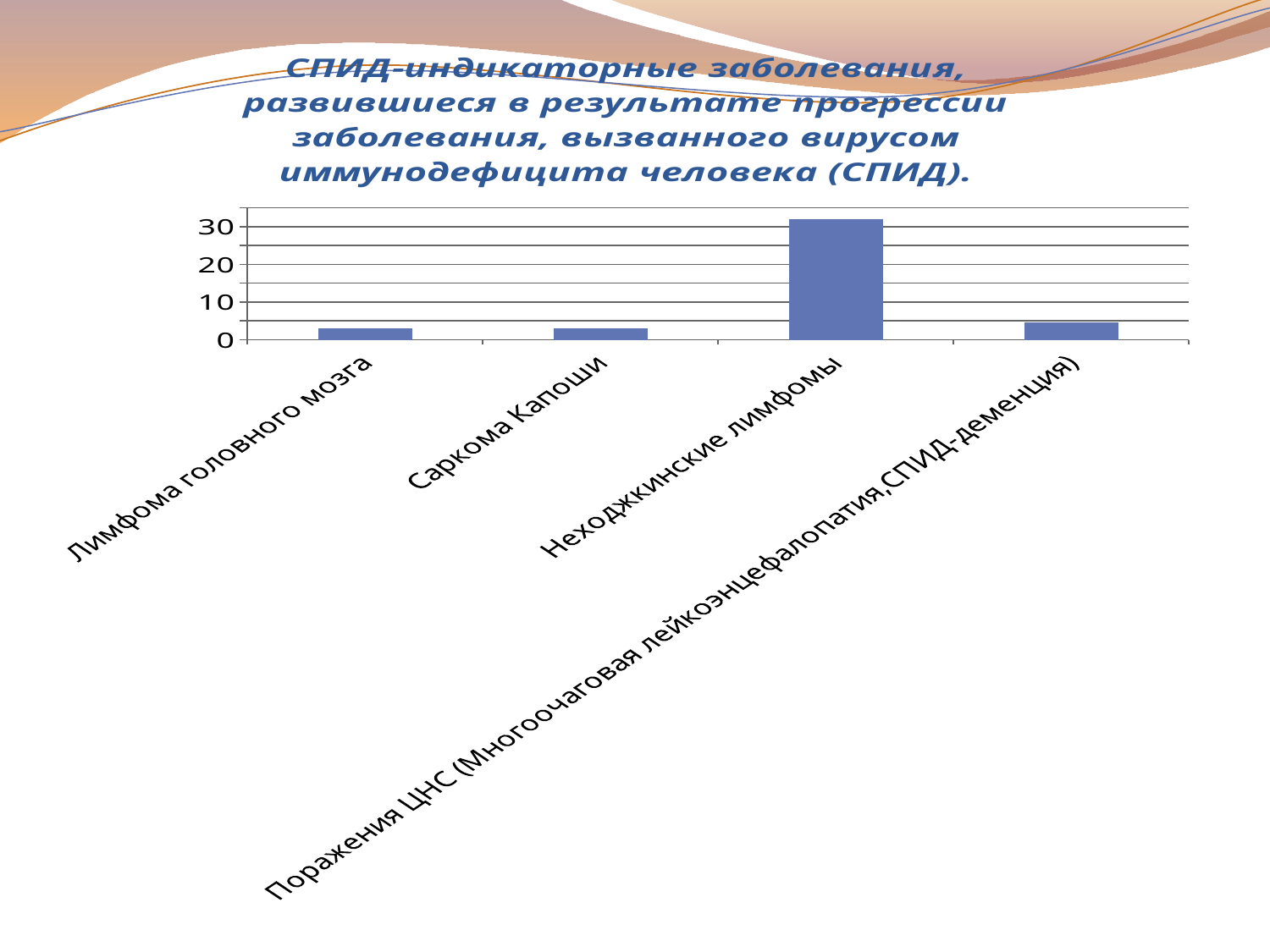
How many categories are plotted in the chart? 4 Which is larger: the value for Неходжкинские лимфомы or the value for Саркома Капоши? Неходжкинские лимфомы What kind of chart is shown on the slide? bar chart Is the value for Саркома Капоши greater or less than 10? less What is the highest tick value shown on the vertical axis of the chart? 30 Is the value for Поражения ЦНС (Многоочаговая лейкоэнцефалопатия,СПИД-деменция) greater or less than 10? less Which category has the highest value in the chart? Неходжкинские лимфомы Is the value for Неходжкинские лимфомы greater or less than 20? greater Which is larger: the value for Лимфома головного мозга or the value for Неходжкинские лимфомы? Неходжкинские лимфомы What colour are the bars in the chart? blue